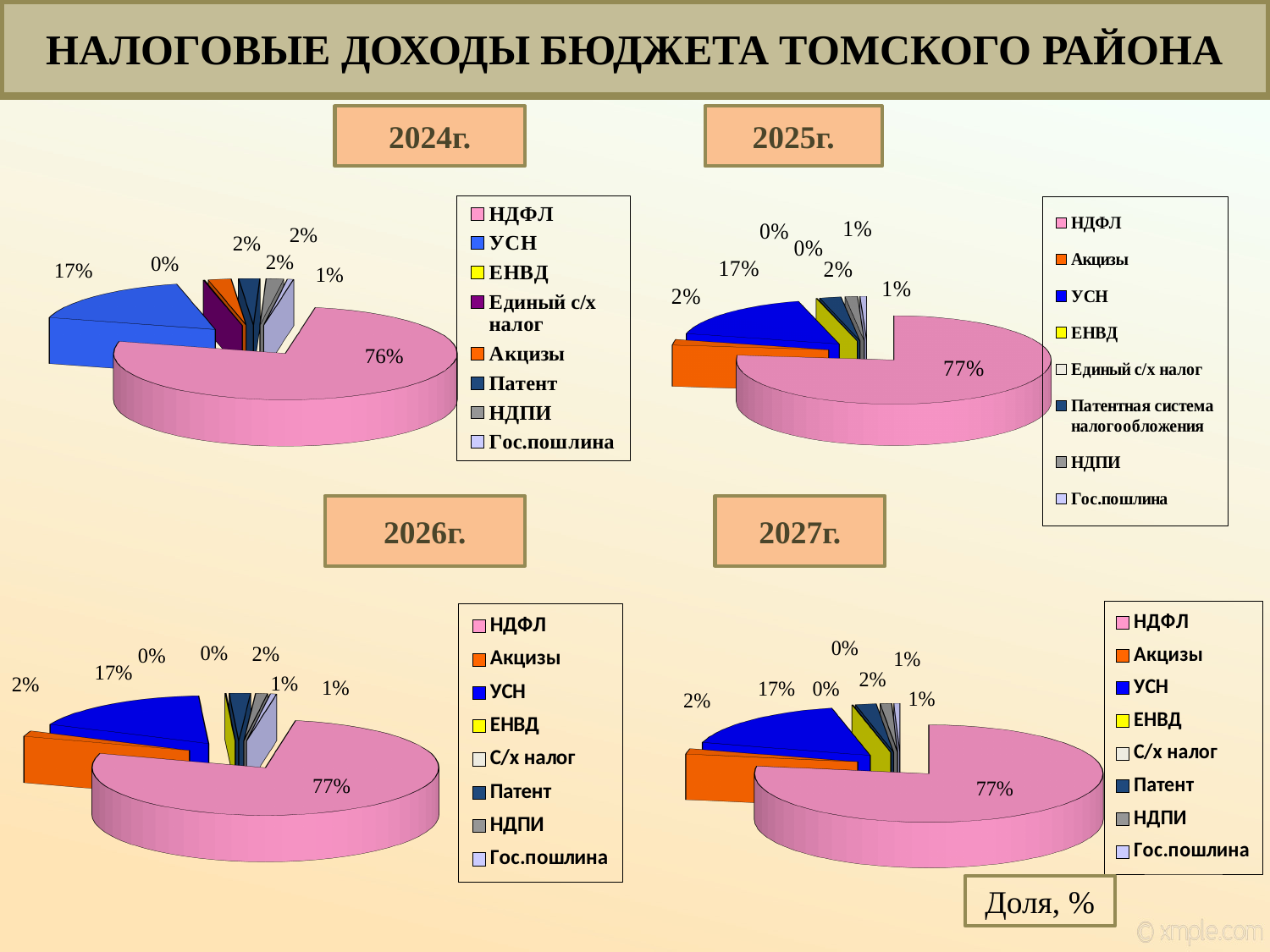
In the 2024г. chart, what share does УСН have? 17% What kind of chart is used for the 2024г. data? Pie chart In the 2026г. chart, which category has the second-largest share? УСН How many entries does the legend of the 2026г. chart list? 8 In the 2024г. chart, what is the difference in percentage points between the НДФЛ share and the УСН share? 59 In the 2025г. chart, what share does НДФЛ have? 77% In the 2024г. chart, which category has the largest share? НДФЛ How many pie charts are shown on the slide? 4 In the 2027г. chart, what share does НДФЛ have? 77% In the 2027г. chart, what share does Акцизы have? 2% Is the НДФЛ share larger in the 2024г. chart or in the 2025г. chart? 2025г. In the 2024г. chart, what share does НДФЛ have? 76%